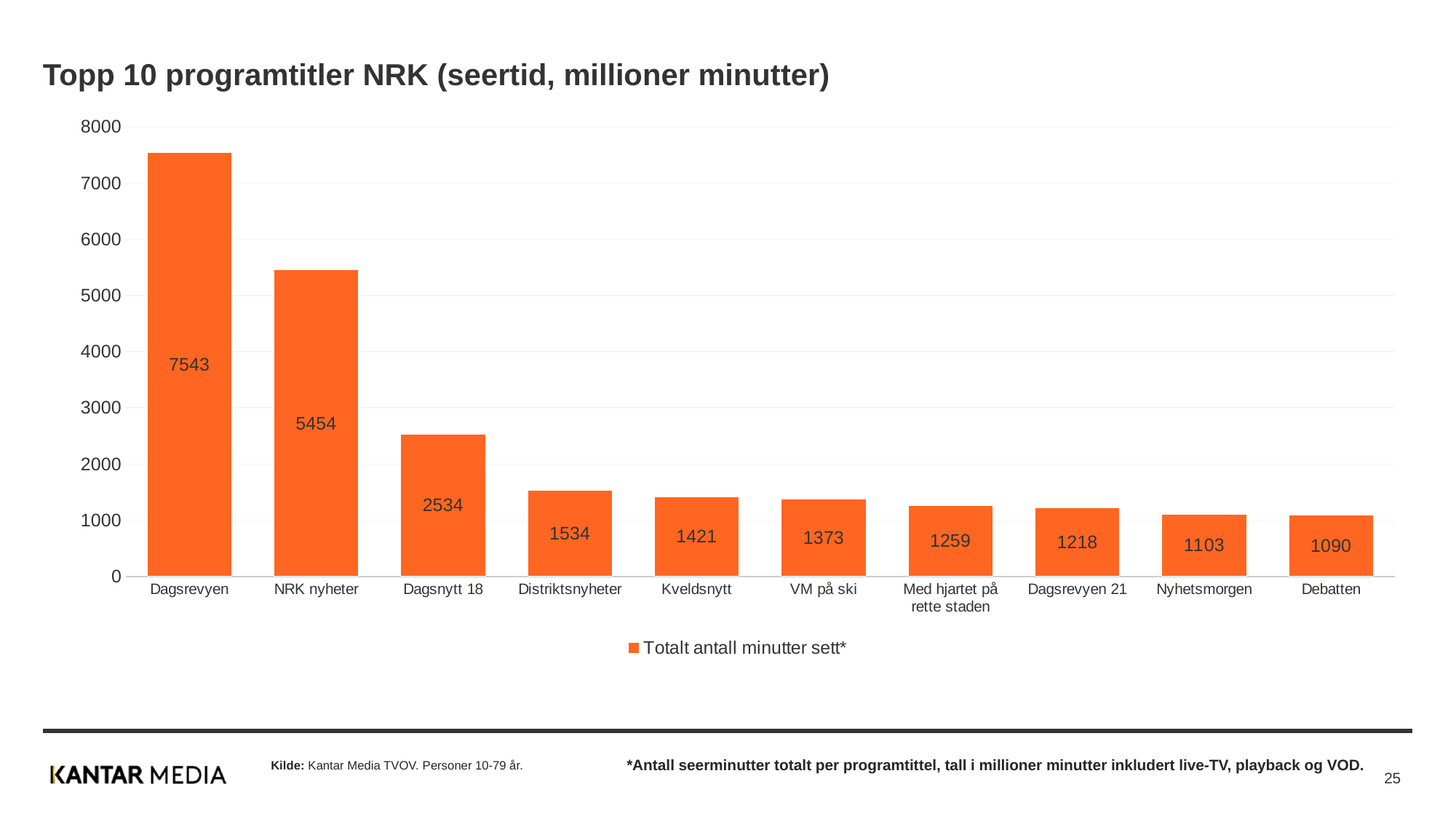
What is the difference between the values for Dagsrevyen and NRK nyheter? 2089 Which program title has the lowest value? Debatten Is the value for NRK nyheter greater or less than 5000? greater How many program titles are shown in the chart? 10 What is the difference between the values for Dagsnytt 18 and Distriktsnyheter? 1000 What is the legend entry for the series shown in the chart? Totalt antall minutter sett* Which program title has the highest value? Dagsrevyen What is the value for Dagsrevyen? 7543 What kind of chart is shown on the slide? Bar chart What is the value for Kveldsnytt? 1421 What is the value for Med hjartet på rette staden? 1259 Which is larger, the value for VM på ski or the value for Dagsrevyen 21? VM på ski